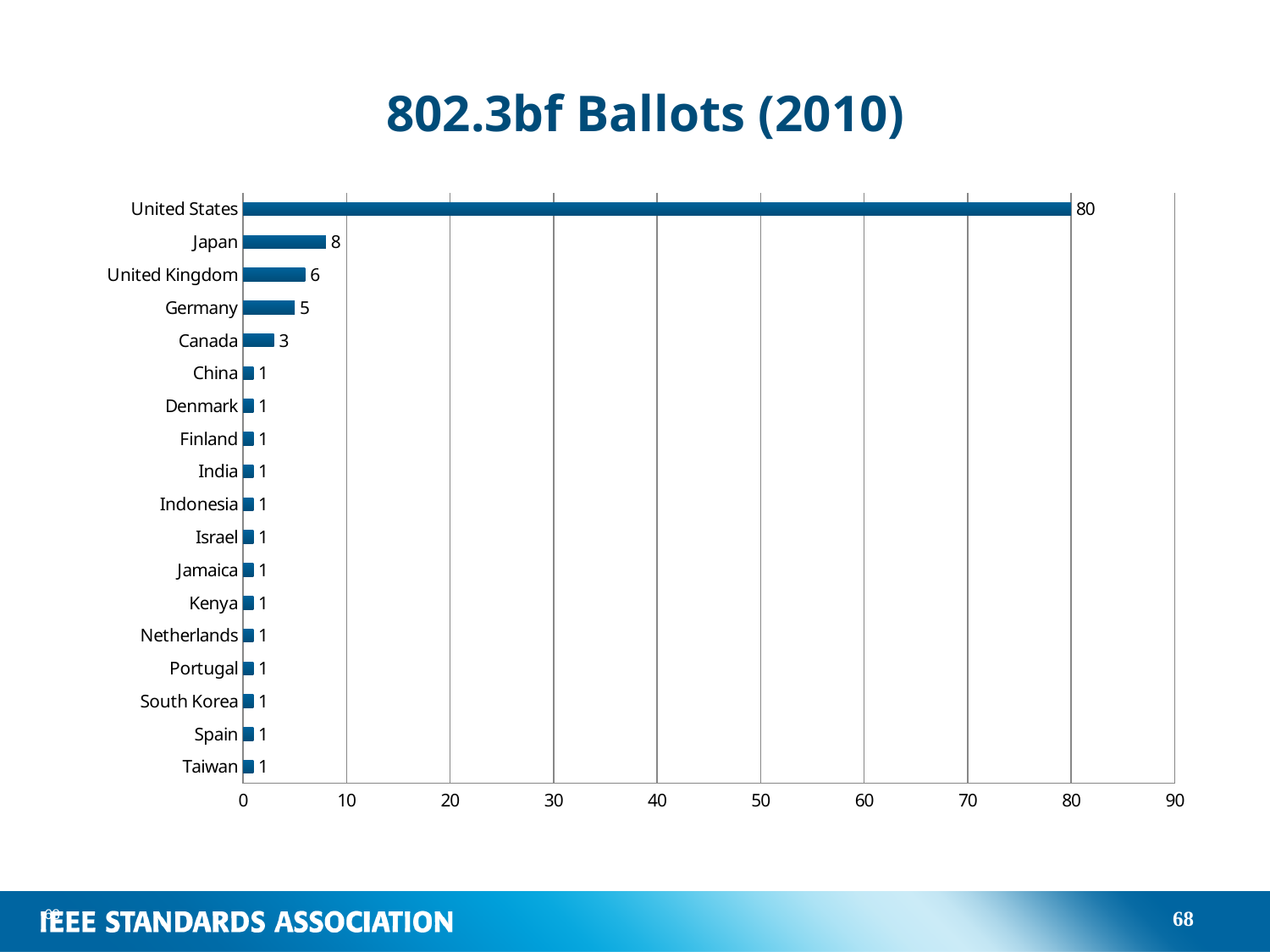
What is the value for United States? 80 How many countries are shown in the chart? 18 What is the value for Germany? 5 What kind of chart is shown on the slide? bar chart Which is larger, the value for Japan or the value for Germany? Japan Is the value for United States greater or less than 70? greater Which country has the highest number of ballots? United States What is the value for Japan? 8 What is the title of the chart? 802.3bf Ballots (2010) What is the difference between the values for United Kingdom and Canada? 3 What is the value for Canada? 3 What is the difference between the values for United States and Japan? 72